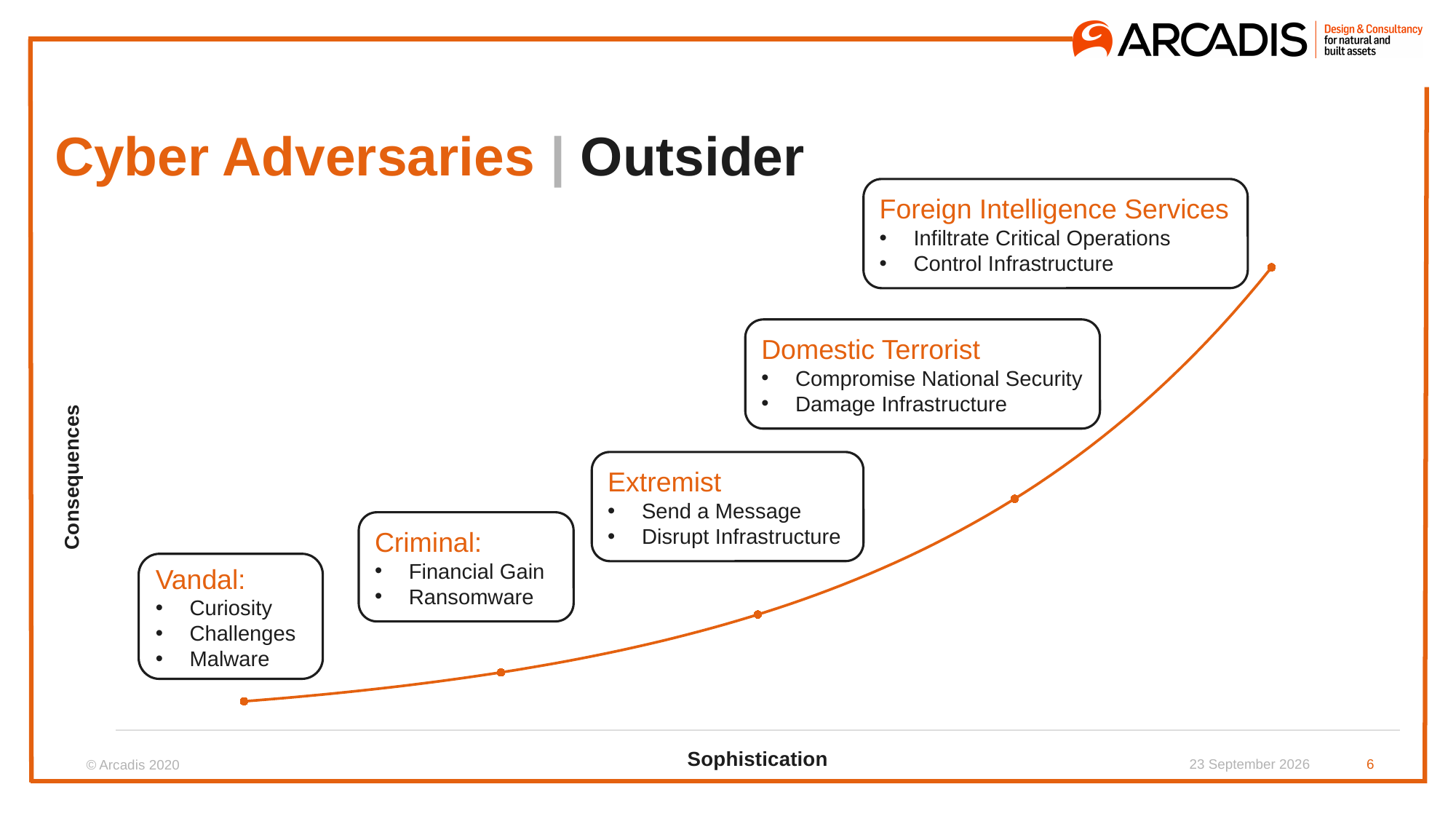
Which adversary is plotted at the lowest point on the Consequences axis? Vandal Which adversary is plotted at the highest point on the Consequences axis? Foreign Intelligence Services What kind of chart is shown on the slide? Line chart What is the label of the vertical axis? Consequences Which is plotted further right on the Sophistication axis, Domestic Terrorist or Extremist? Domestic Terrorist Which is plotted higher on the Consequences axis, Extremist or Criminal? Extremist What is the label of the horizontal axis? Sophistication How many data points are plotted on the line? 5 Do the values rise or fall along the x axis from left to right? Rise Which adversary is plotted at the second-lowest point on the line? Criminal